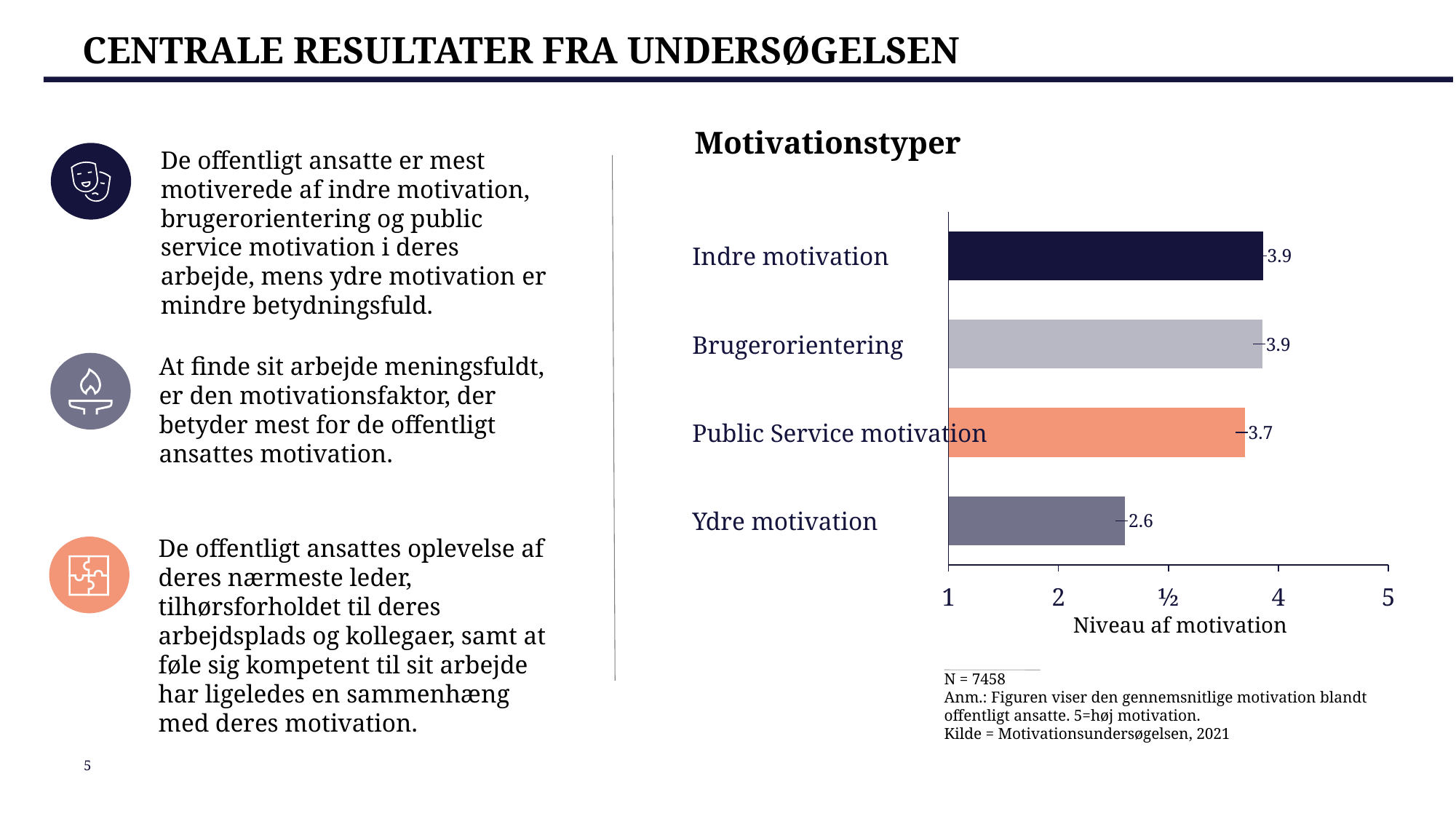
How many categories are shown in the Motivationstyper chart? 4 What is the value for Brugerorientering in the Motivationstyper chart? 3.9 Is the value for Ydre motivation greater or less than 2? greater What is the value for Ydre motivation in the Motivationstyper chart? 2.6 Which is larger, the value for Public Service motivation or the value for Ydre motivation? Public Service motivation What is the label of the x axis in the Motivationstyper chart? Niveau af motivation What kind of chart is the Motivationstyper chart? bar chart What is the value for Indre motivation in the Motivationstyper chart? 3.9 What is the value for Public Service motivation in the Motivationstyper chart? 3.7 What is the difference between the values for Public Service motivation and Ydre motivation? 1.1 What is the difference between the values for Indre motivation and Ydre motivation? 1.3 Which category has the lowest value in the Motivationstyper chart? Ydre motivation